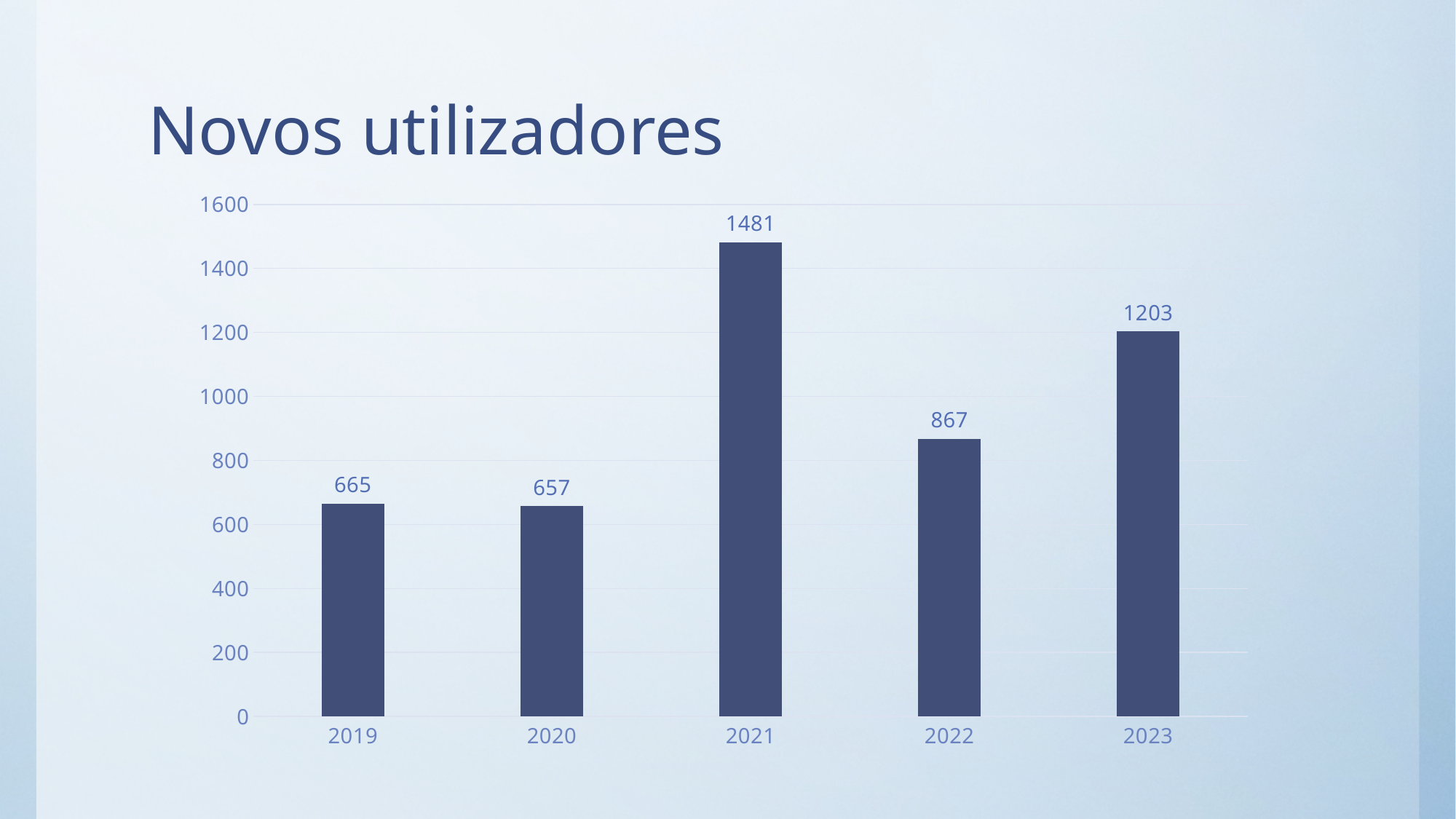
Is the value for 2022 greater or less than 1000? less What kind of chart is shown on the slide? bar chart What is the value for 2019? 665 What is the difference between the values for 2023 and 2019? 538 How many years are shown on the x axis? 5 What is the difference between the values for 2021 and 2022? 614 What is the value for 2023? 1203 Which is larger, the value for 2022 or the value for 2023? 2023 Which year has the highest value? 2021 What is the value for 2021? 1481 Which year has the lowest value? 2020 What is the title of the slide? Novos utilizadores